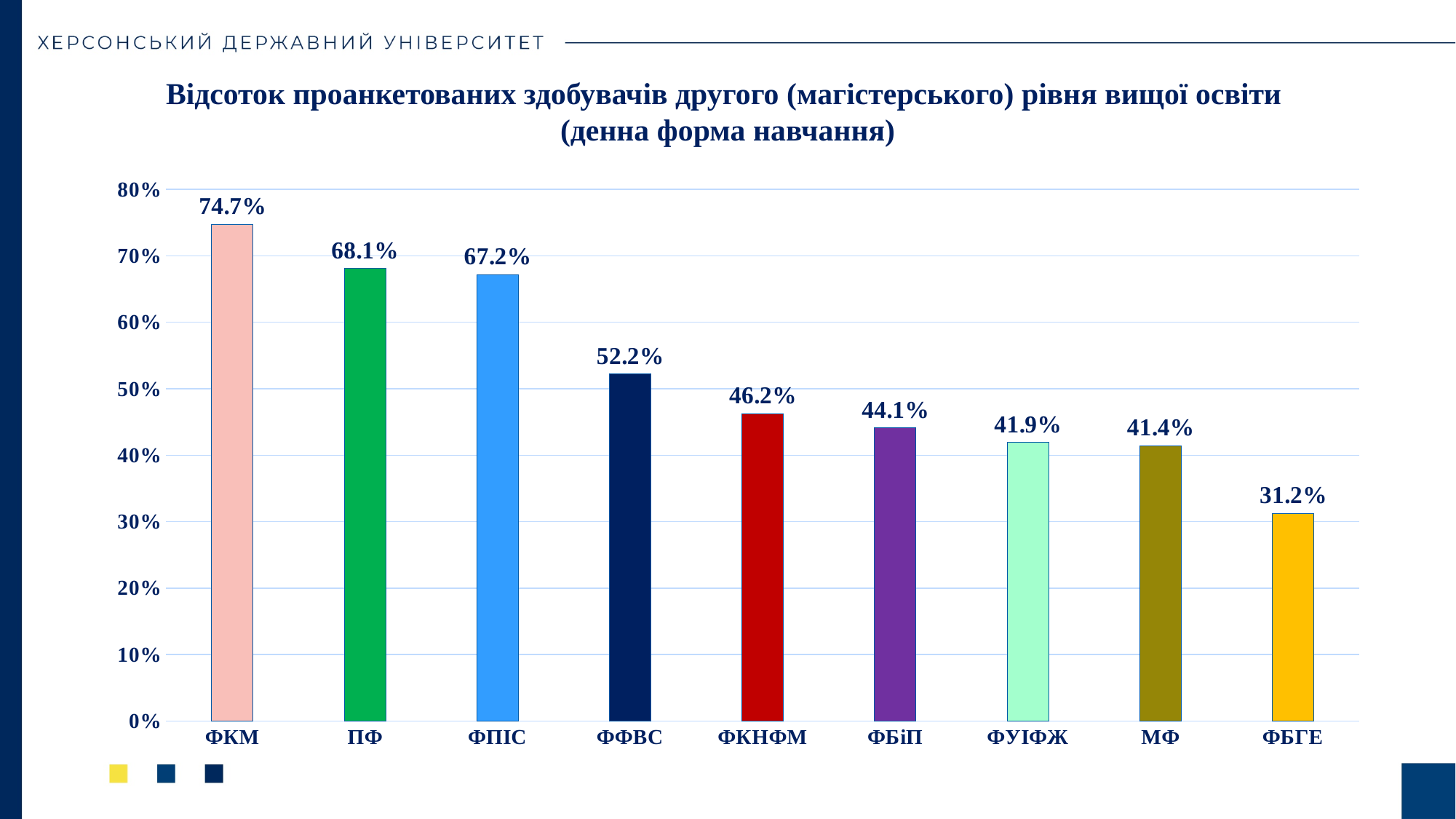
What is the value for ФКМ? 74.7% What is the value for ФФВС? 52.2% What is the difference between the values for ПФ and ФПІС? 0.9% Do the values rise or fall from left to right along the x axis? fall What kind of chart is shown on the slide? bar chart What is the value for ФБГЕ? 31.2% Which category has the lowest value? ФБГЕ What is the value for ФУІФЖ? 41.9% Which category has the highest value? ФКМ Which is larger, the value for ФКНФМ or the value for ФБіП? ФКНФМ What is the difference between the values for ФКМ and ФБГЕ? 43.5% How many categories are shown on the chart? 9